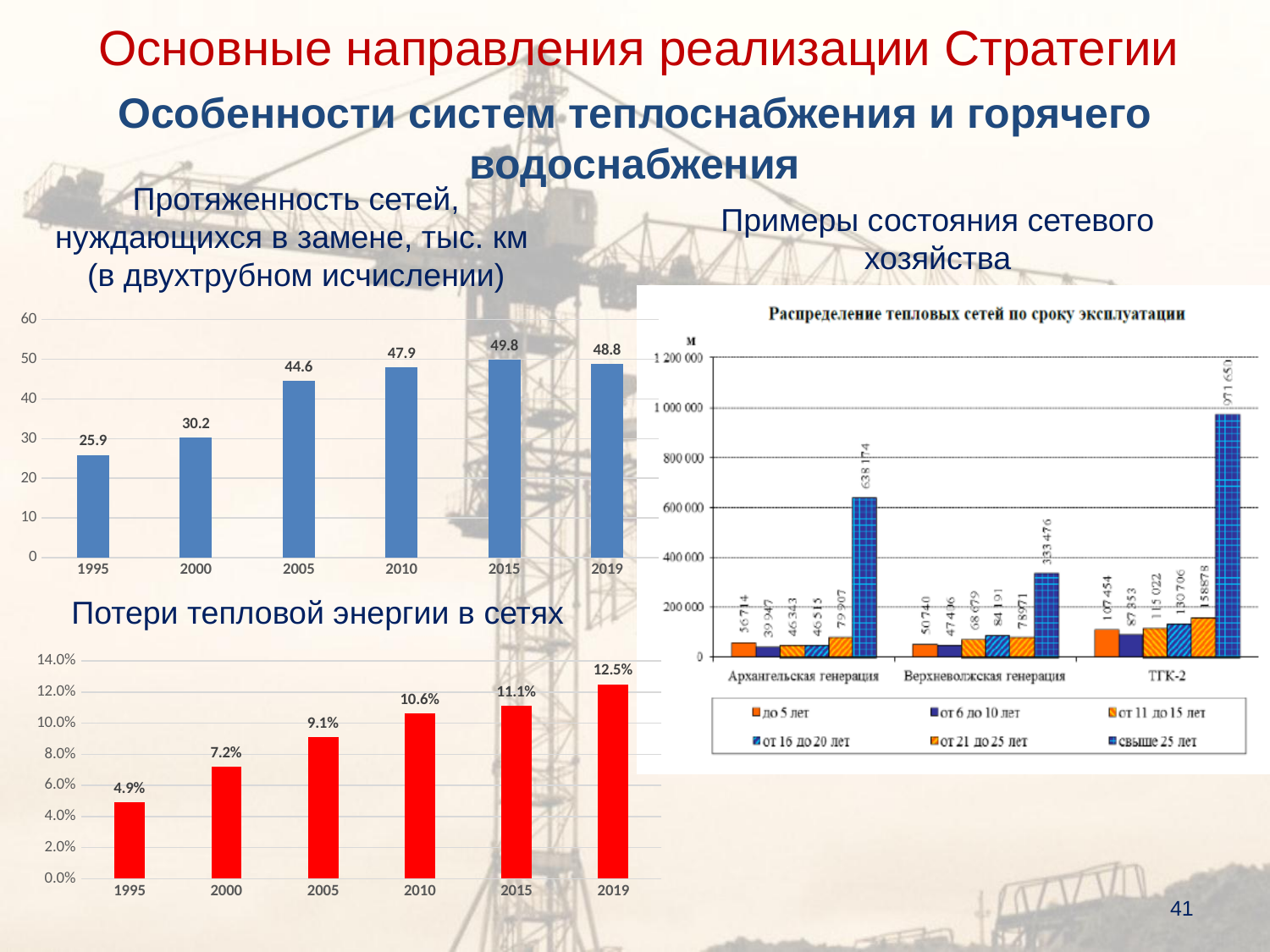
In the top-left chart (Протяженность сетей, нуждающихся в замене), what is the difference between the values for 2019 and 1995? 22.9 In the top-left chart (Протяженность сетей, нуждающихся в замене), what is the value for 2005? 44.6 In the bottom-left chart (Потери тепловой энергии в сетях), what is the value for 2010? 10.6% What kind of chart is the bottom-left chart (Потери тепловой энергии в сетях)? bar chart In the right chart (Распределение тепловых сетей по сроку эксплуатации), is the value for 'свыше 25 лет' in Архангельская генерация greater or less than 400 000? greater How many years are shown on the x axis of the top-left chart (Протяженность сетей, нуждающихся в замене)? 6 In the top-left chart (Протяженность сетей, нуждающихся в замене), which year has the lowest value? 1995 In the bottom-left chart (Потери тепловой энергии в сетях), do the values rise or fall from 1995 to 2019? rise In the right chart (Распределение тепловых сетей по сроку эксплуатации), how many series does the legend list? 6 In the bottom-left chart (Потери тепловой энергии в сетях), what is the value for 1995? 4.9% In the right chart (Распределение тепловых сетей по сроку эксплуатации), which category has the highest value for the series 'свыше 25 лет'? ТГК-2 In the top-left chart (Протяженность сетей, нуждающихся в замене), which year has the highest value? 2015